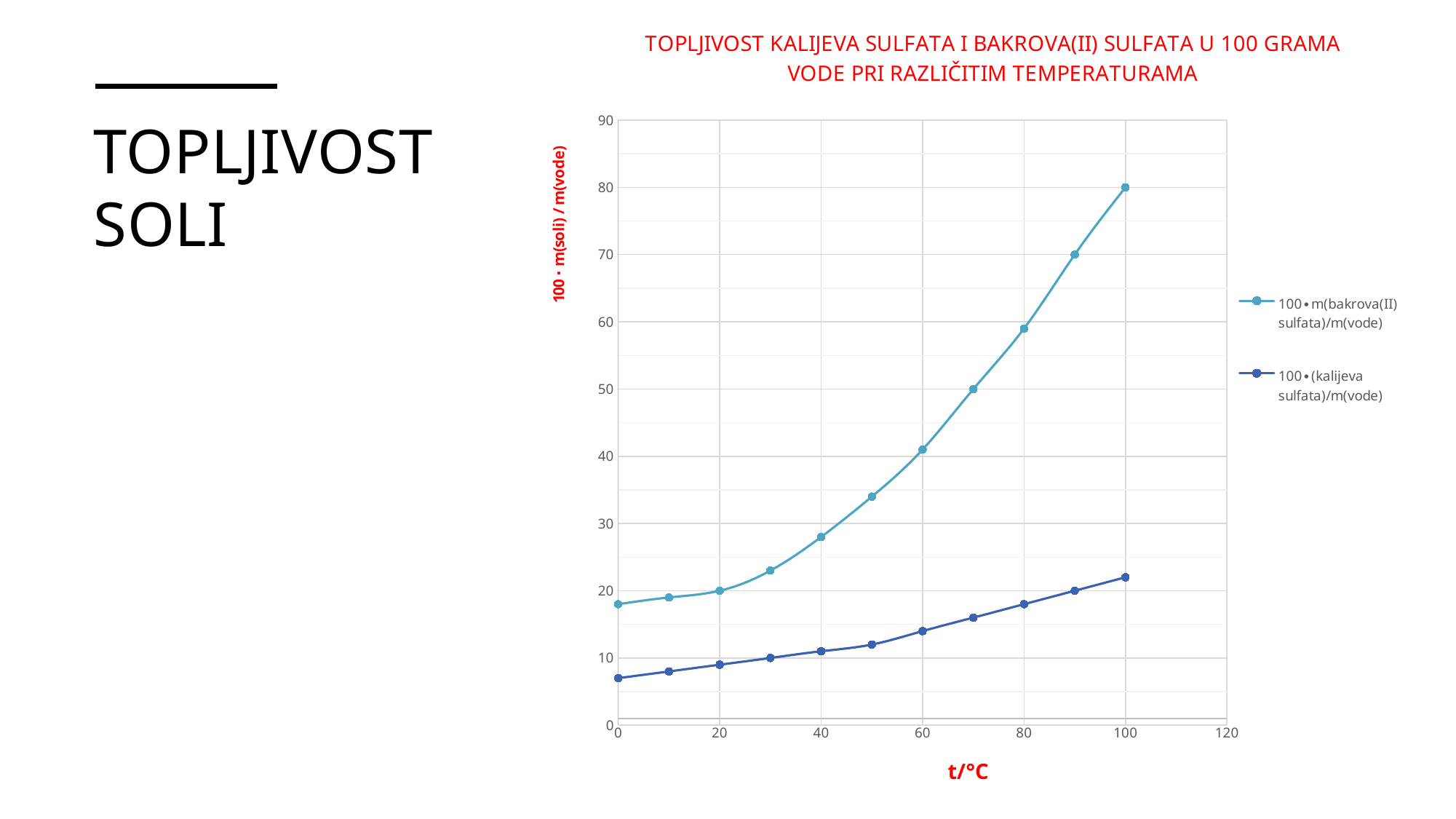
What kind of chart is shown on the slide? line chart Is the value of the kalijeva sulfata series at 0 °C greater or less than 10? less What is the value of the bakrova(II) sulfata series at 70 °C? 50 Which series has the higher value at 100 °C, bakrova(II) sulfata or kalijeva sulfata? bakrova(II) sulfata How many data points does the bakrova(II) sulfata series have? 11 What is the value of the kalijeva sulfata series at 30 °C? 10 How many series does the legend list? 2 What is the value of the kalijeva sulfata series at 90 °C? 20 What is the label of the x axis of the chart? t/°C Do the values of the bakrova(II) sulfata series rise or fall as temperature increases? rise What is the value of the bakrova(II) sulfata series at 100 °C? 80